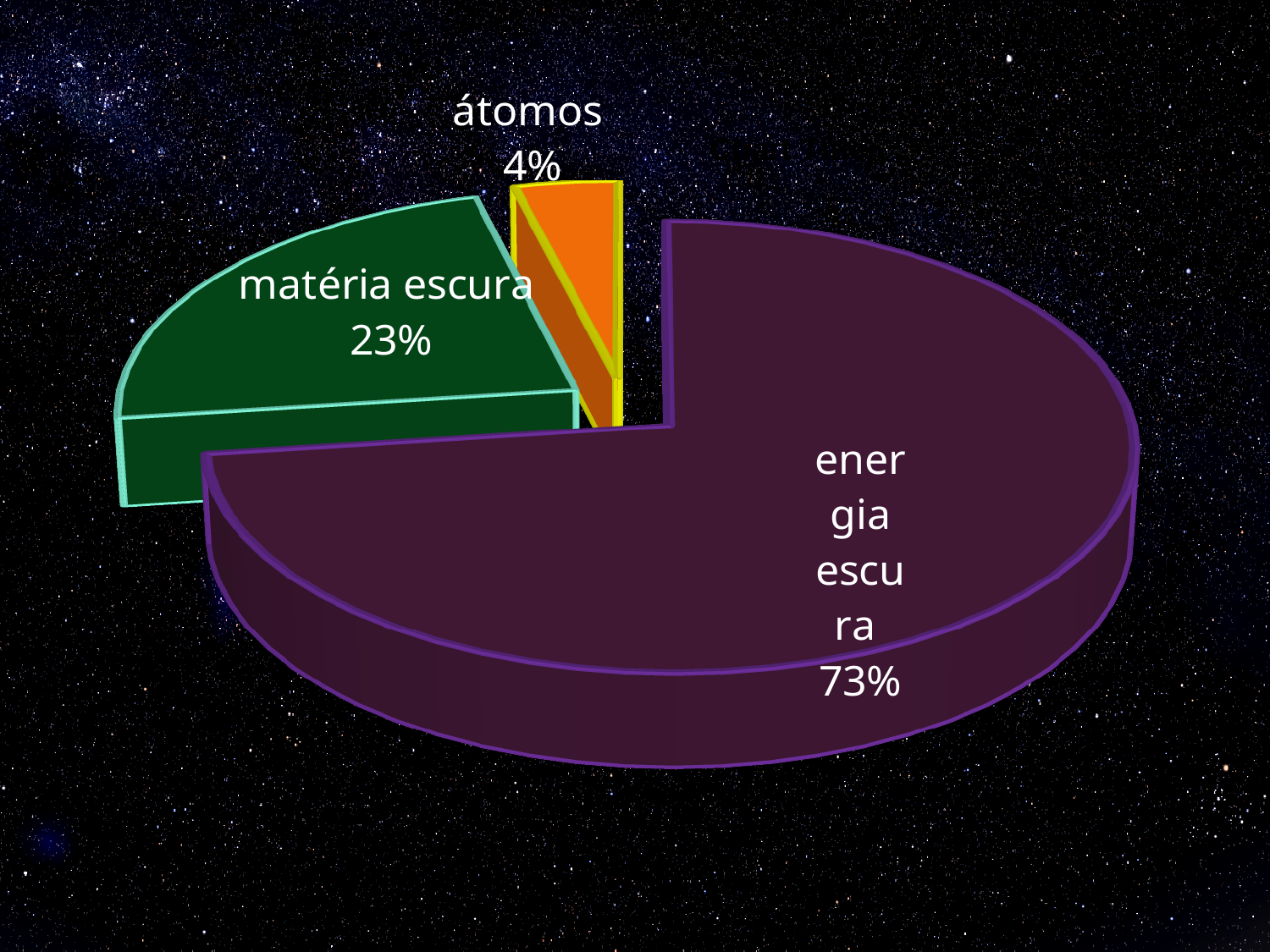
What colour is the 'matéria escura' slice? green What is the difference in percentage points between 'matéria escura' and 'átomos'? 19 What is the difference in percentage points between 'energia escura' and 'matéria escura'? 50 Which slice of the pie is the largest? energia escura How many slices does the pie chart have? 3 Which is larger, the 'matéria escura' slice or the 'átomos' slice? matéria escura What kind of chart is shown on the slide? pie chart Which slice of the pie is the smallest? átomos What percentage does the 'matéria escura' slice represent? 23% What percentage does the 'átomos' slice represent? 4% What colour is the 'átomos' slice? orange What percentage does the 'energia escura' slice represent? 73%